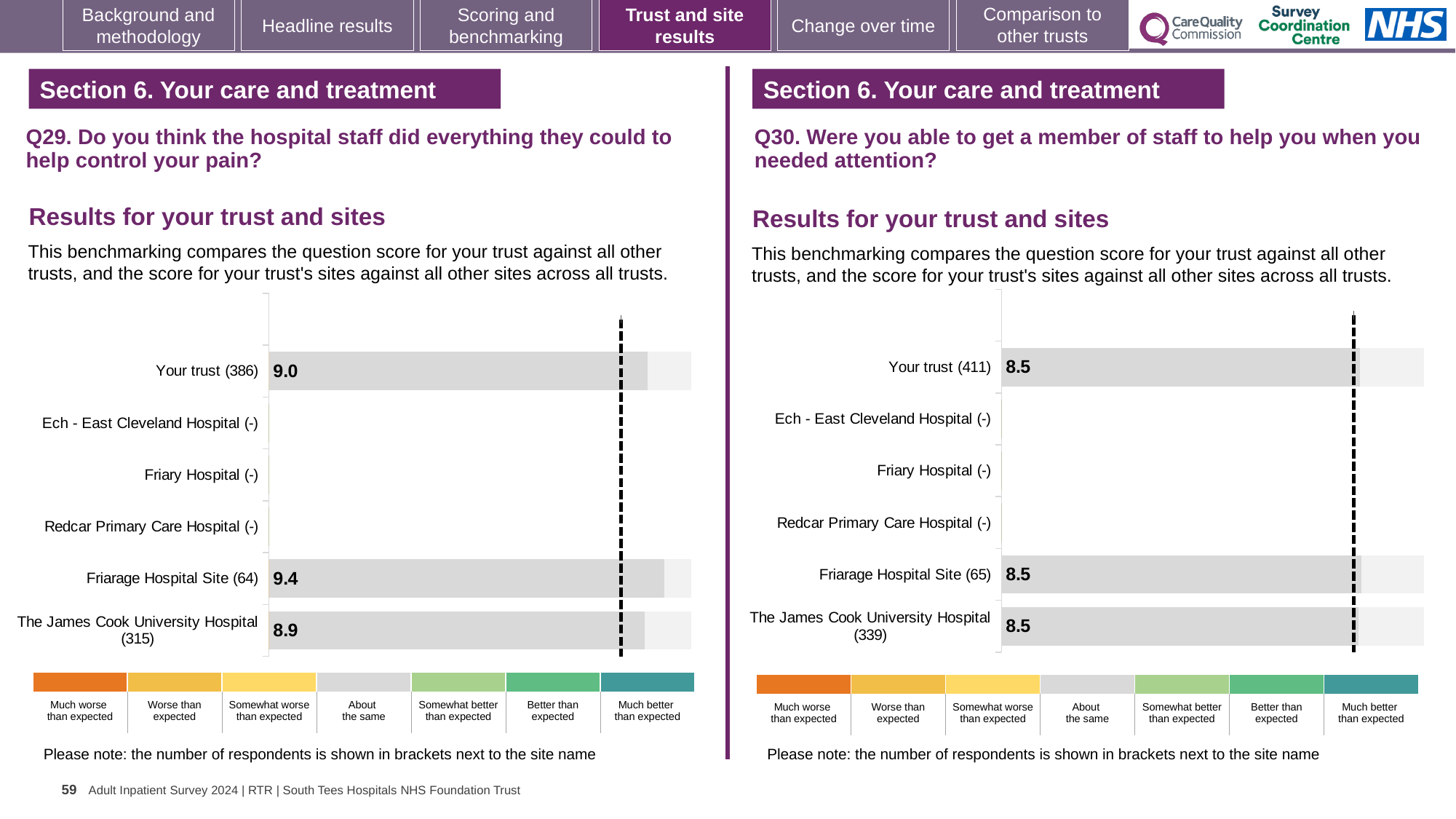
In the Q30 chart on the right, what is the score for Your trust (411)? 8.5 In the Q30 chart on the right, what is the score for The James Cook University Hospital (339)? 8.5 In the Q30 chart on the right, how many respondents are shown in brackets for Friarage Hospital Site? 65 In the Q29 chart on the left, which has a higher score: Your trust or The James Cook University Hospital? Your trust In the Q29 chart on the left, which site has the highest score? Friarage Hospital Site (64) In the Q29 chart on the left, what is the score for The James Cook University Hospital (315)? 8.9 How many site/trust categories are listed on the y axis of the Q30 chart on the right? 6 What kind of chart is used for the Q29 results on the left? Bar chart In the Q29 chart on the left, which labelled bar has the lowest score? The James Cook University Hospital (315) In the Q29 chart on the left, what is the score for Your trust (386)? 9.0 In the Q29 chart on the left, what is the score for Friarage Hospital Site (64)? 9.4 In the Q29 chart on the left, what is the difference between the Friarage Hospital Site score and The James Cook University Hospital score? 0.5